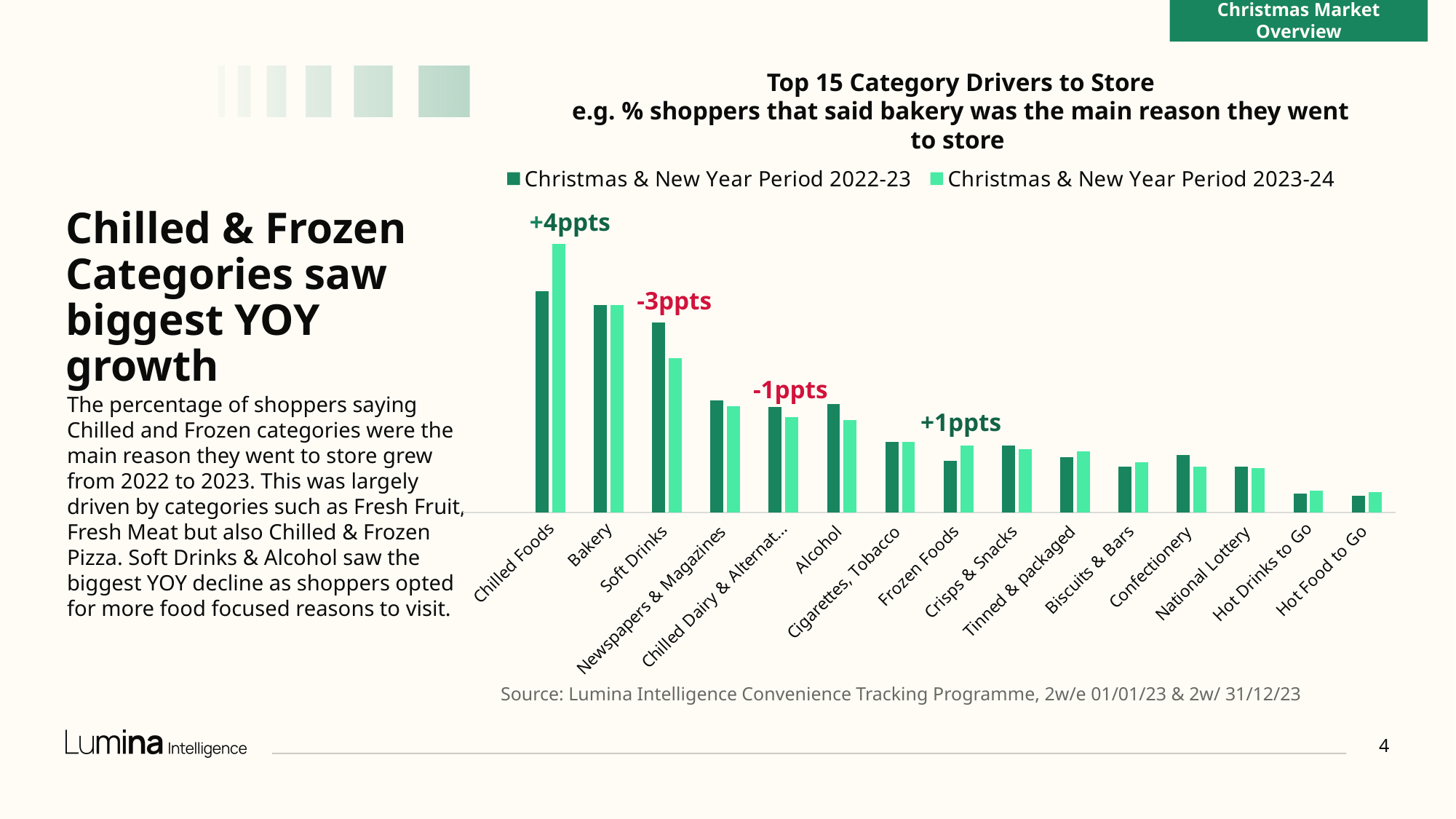
Do the values generally rise or fall moving from left to right along the x axis? Fall What is the first line of the chart's title? Top 15 Category Drivers to Store What year-on-year change is annotated above the Chilled Foods bars? +4ppts What year-on-year change is annotated above the Soft Drinks bars? -3ppts Which category has the highest value for Christmas & New Year Period 2023-24? Chilled Foods What year-on-year change is annotated above the Frozen Foods bars? +1ppts What kind of chart is shown on the slide? Bar chart How many categories are shown on the x axis of the chart? 15 How many series does the chart legend list? 2 For Chilled Foods, which series has the larger value: Christmas & New Year Period 2022-23 or Christmas & New Year Period 2023-24? Christmas & New Year Period 2023-24 Which category has the highest value for Christmas & New Year Period 2022-23? Chilled Foods For Soft Drinks, which series has the larger value: Christmas & New Year Period 2022-23 or Christmas & New Year Period 2023-24? Christmas & New Year Period 2022-23